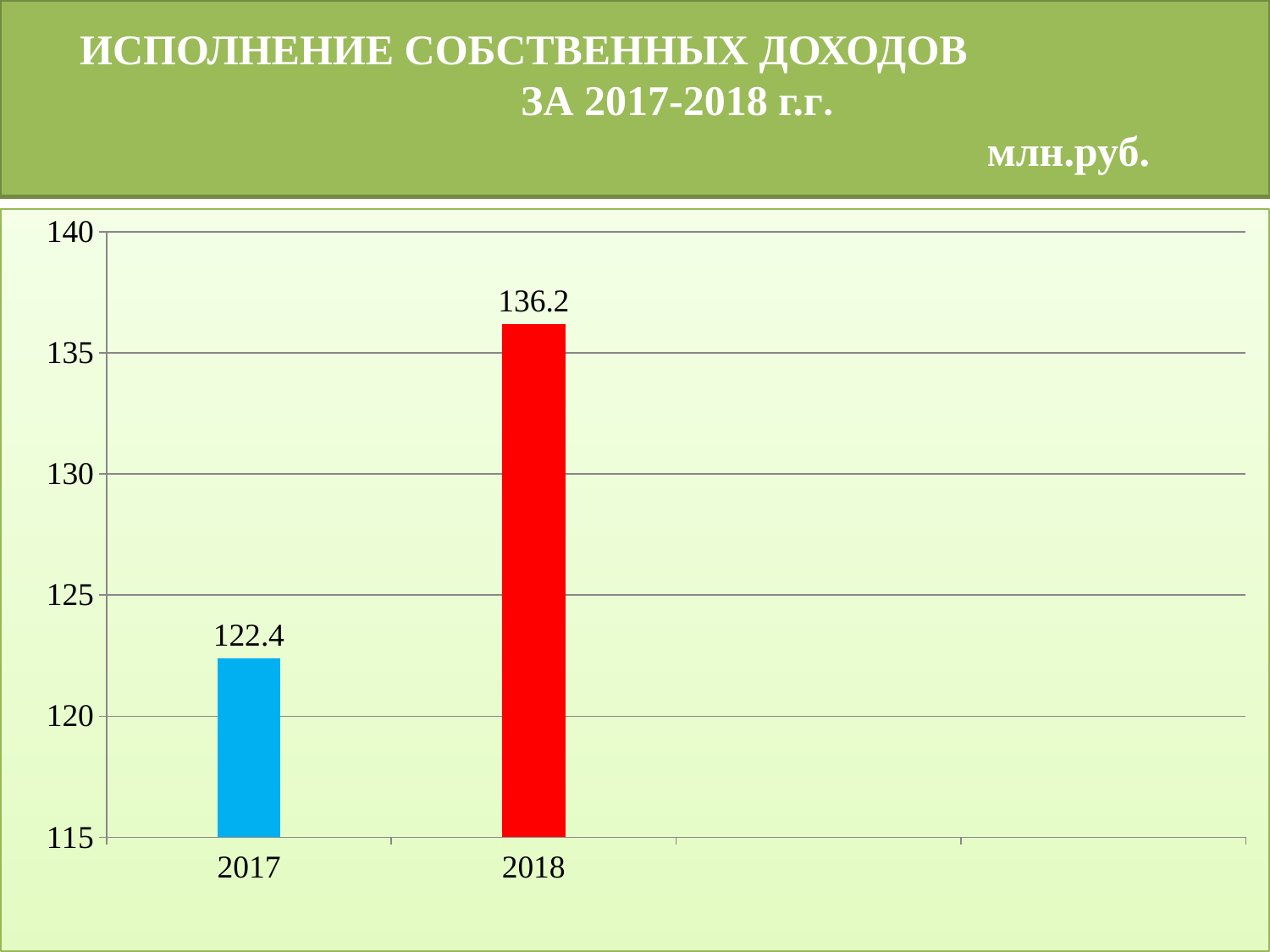
How many bars are plotted in the chart? 2 What kind of chart is shown on the slide? bar chart Do the values rise or fall from 2017 to 2018? rise Is the value for 2018 greater or less than 135? greater What is the value for 2017? 122.4 What is the value for 2018? 136.2 Which year has the highest value? 2018 What unit is stated for the values in the chart? млн.руб. What is the difference between the values for 2018 and 2017? 13.8 Which year has the lowest value? 2017 Which is larger, the value for 2017 or the value for 2018? 2018 Is the value for 2017 greater or less than 125? less